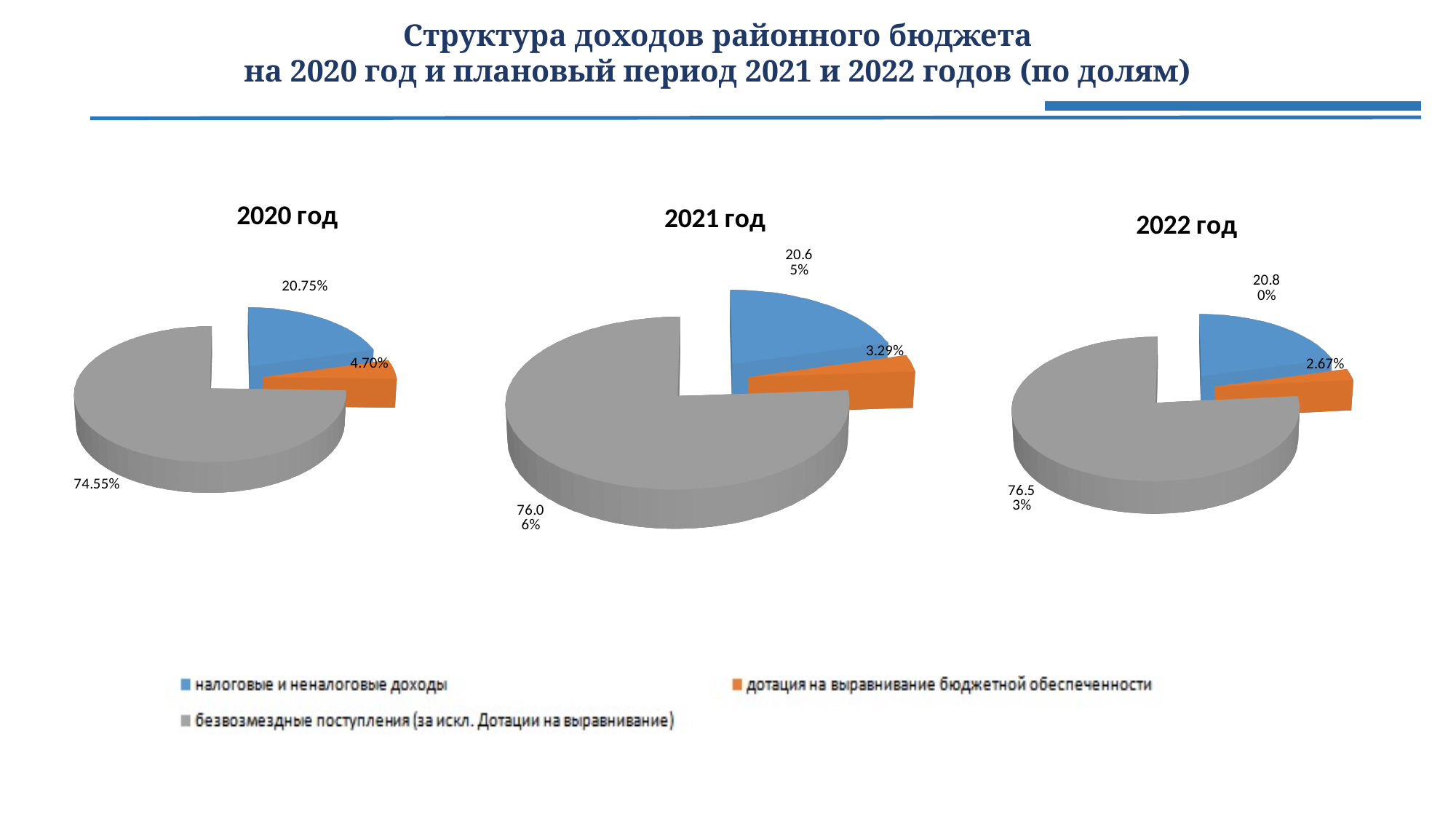
In the 2022 год chart, which category has the smallest share? дотация на выравнивание бюджетной обеспеченности Which colour represents налоговые и неналоговые доходы in the charts? Blue In the 2020 год chart, what is the share of налоговые и неналоговые доходы? 20.75% In the 2020 год chart, what is the share of безвозмездные поступления (за искл. Дотации на выравнивание)? 74.55% How many entries does the legend list? 3 What kind of charts are shown on the slide? Pie charts Which is larger: the share of дотация на выравнивание бюджетной обеспеченности in the 2020 год chart or in the 2021 год chart? 2020 год In the 2022 год chart, what is the share of дотация на выравнивание бюджетной обеспеченности? 2.67% In the 2020 год chart, which category has the largest share? безвозмездные поступления (за искл. Дотации на выравнивание) How many pie charts are on the slide? 3 In the 2020 год chart, what is the share of дотация на выравнивание бюджетной обеспеченности? 4.70% In the 2021 год chart, what is the share of дотация на выравнивание бюджетной обеспеченности? 3.29%